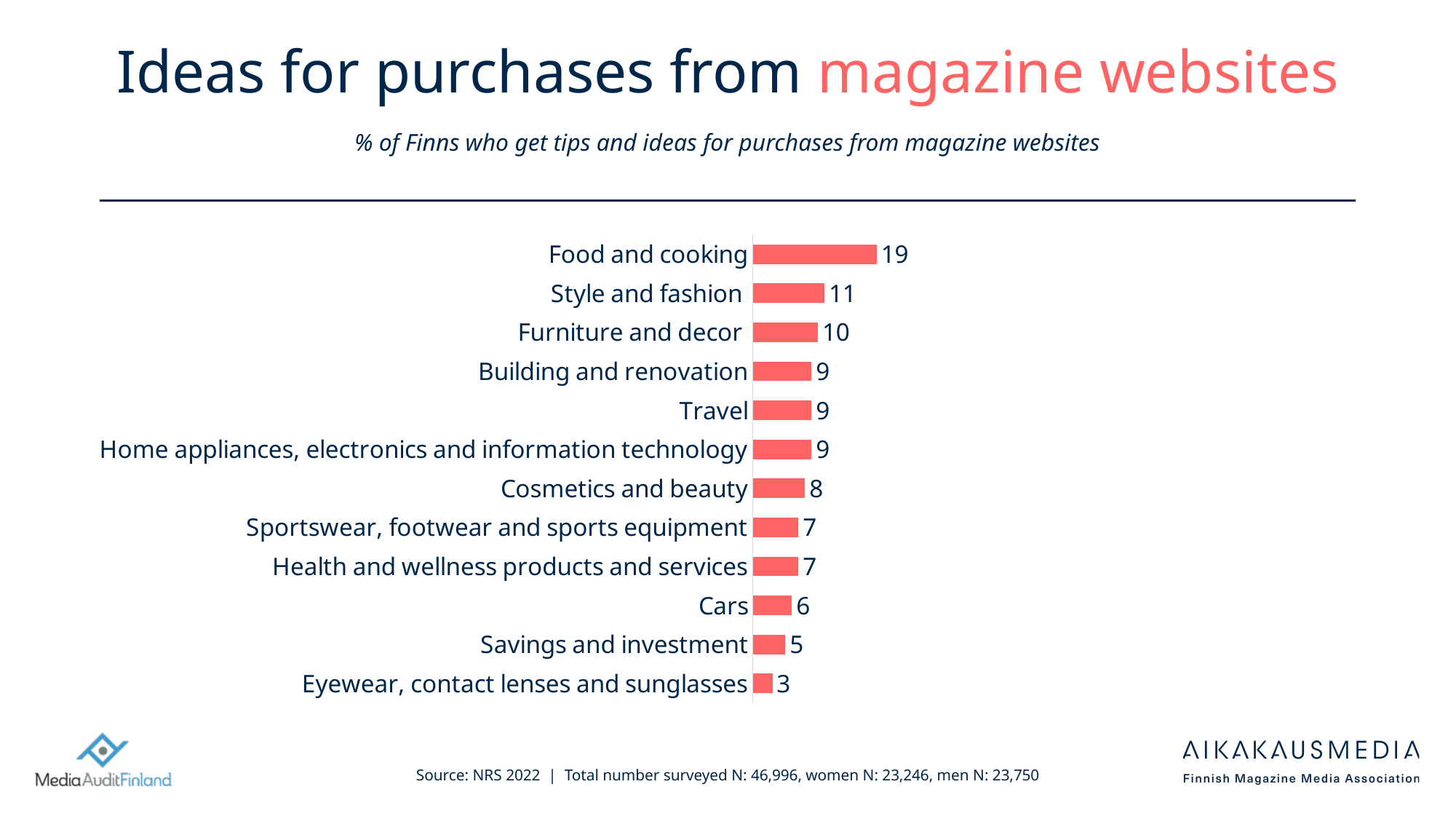
Which is larger, the value for Furniture and decor or the value for Cars? Furniture and decor Which category has the highest value? Food and cooking What is the value for Food and cooking? 19 How many categories are shown in the chart? 12 What is the value for Style and fashion? 11 What kind of chart is shown on the slide? Bar chart What is the title of the slide? Ideas for purchases from magazine websites What is the value for Cosmetics and beauty? 8 What is the difference between the values for Savings and investment and Eyewear, contact lenses and sunglasses? 2 What is the value for Eyewear, contact lenses and sunglasses? 3 What is the difference between the values for Food and cooking and Style and fashion? 8 Which category has the lowest value? Eyewear, contact lenses and sunglasses